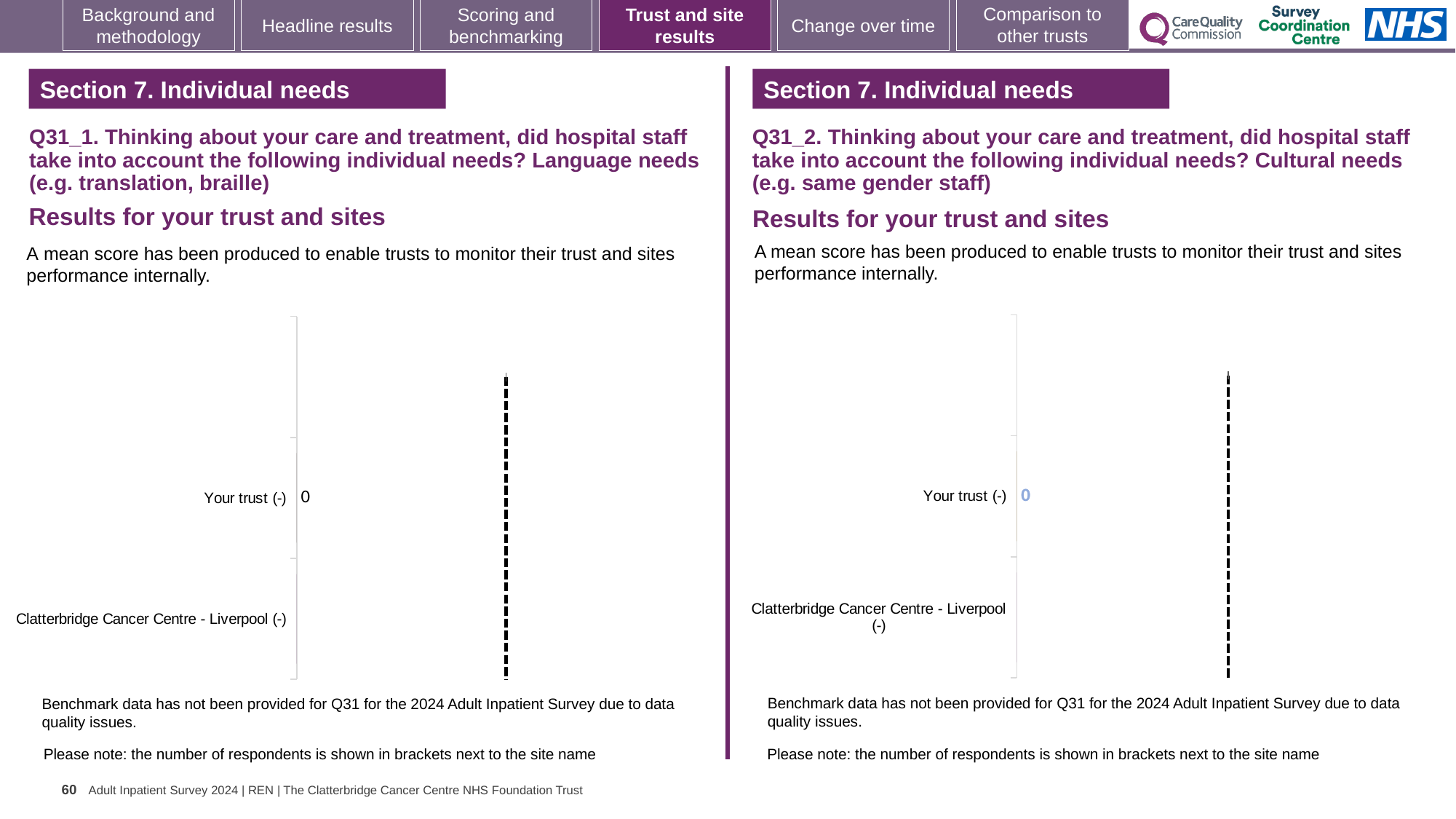
How many categories are listed on the vertical axis of the right chart (Q31_2, Cultural needs)? 2 According to the note under the right chart (Q31_2, Cultural needs), why has benchmark data not been provided for Q31? Due to data quality issues In the left chart (Q31_1, Language needs), which category is listed below Your trust (-)? Clatterbridge Cancer Centre - Liverpool (-) In the left chart (Q31_1, Language needs), what value is shown for Your trust (-)? 0 How many categories are listed on the vertical axis of the left chart (Q31_1, Language needs)? 2 In the right chart (Q31_2, Cultural needs), what value is shown for Your trust (-)? 0 How many charts are shown on the slide? 2 What kind of chart is the left chart (Q31_1, Language needs)? Bar chart